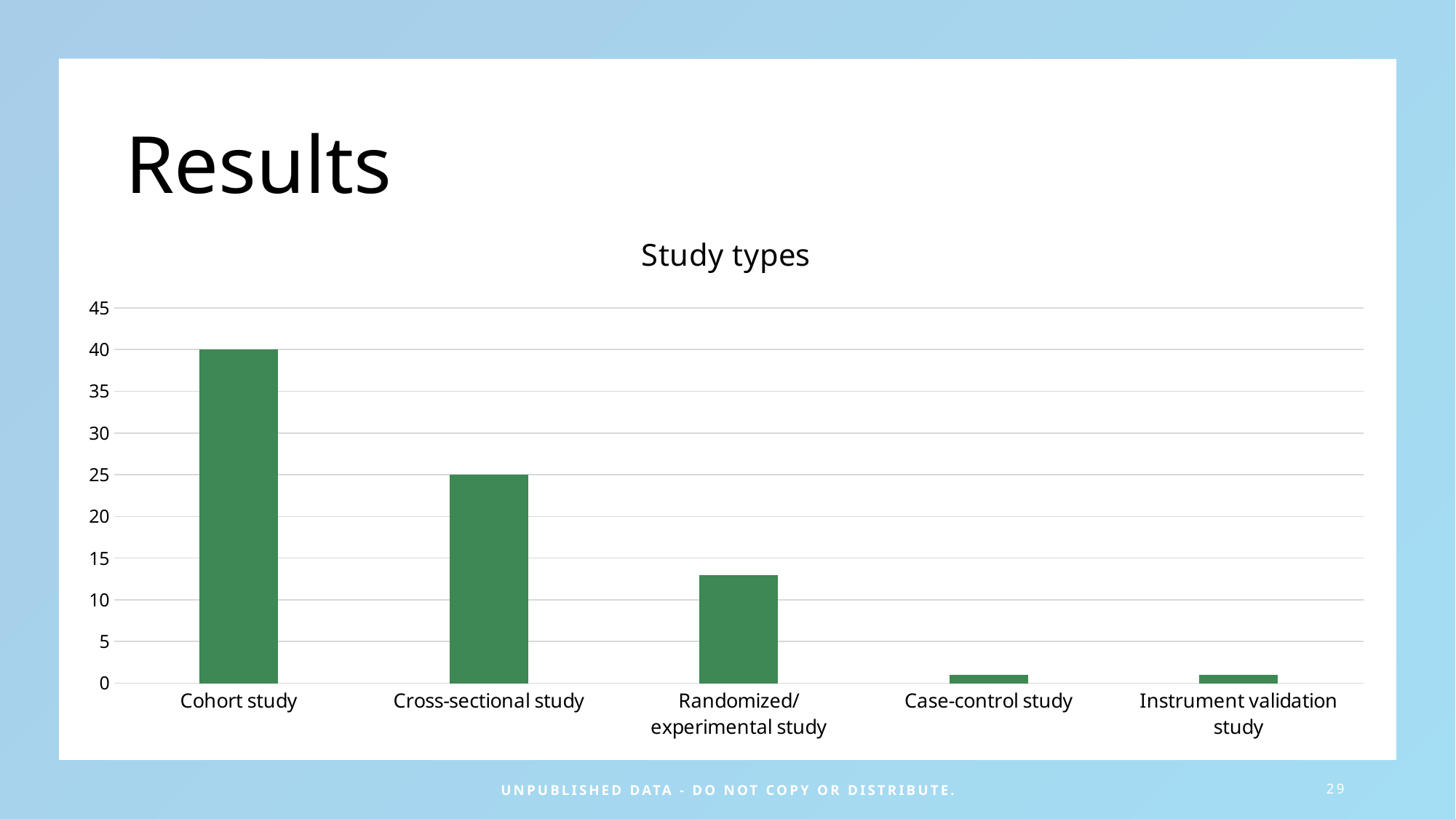
Is the value for Case-control study greater or less than 5? less What is the value for Cohort study? 40 Is the value for Randomized/experimental study greater or less than 15? less Which study type has the highest value? Cohort study Which is larger, the value for Cross-sectional study or the value for Randomized/experimental study? Cross-sectional study What type of chart is shown on the slide? Bar chart Is the value for Randomized/experimental study greater or less than 10? greater What is the value for Cross-sectional study? 25 Do the values rise or fall from left to right along the x axis? Fall What is the title of the chart? Study types How many study types are shown on the x axis? 5 What is the difference between the values for Cohort study and Cross-sectional study? 15